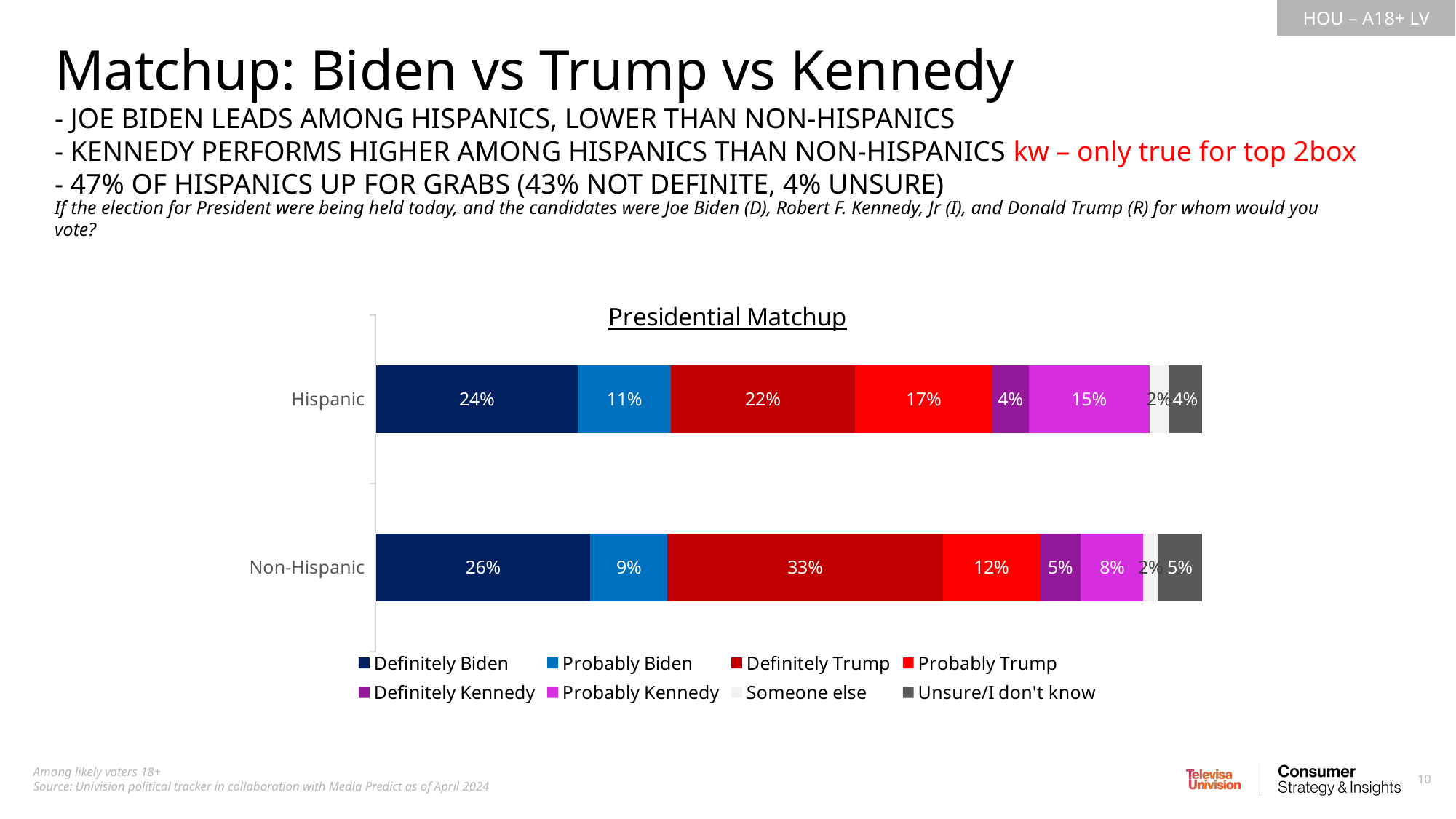
What is the difference between the Definitely Trump values for Non-Hispanic and Hispanic voters? 11% How many series does the legend list? 8 What type of chart is shown under the title "Presidential Matchup"? Stacked bar chart What is the Unsure/I don't know value for Non-Hispanic voters? 5% Which group has the higher Probably Kennedy value, Hispanic or Non-Hispanic? Hispanic Which series has the smallest value in the Hispanic bar? Someone else What is the Definitely Biden value for Hispanic voters? 24% What is the Probably Kennedy value for Hispanic voters? 15% Which series has the largest value in the Non-Hispanic bar? Definitely Trump How many categories (groups) are shown on the chart? 2 What is the Definitely Trump value for Non-Hispanic voters? 33% What is the title of the chart? Presidential Matchup